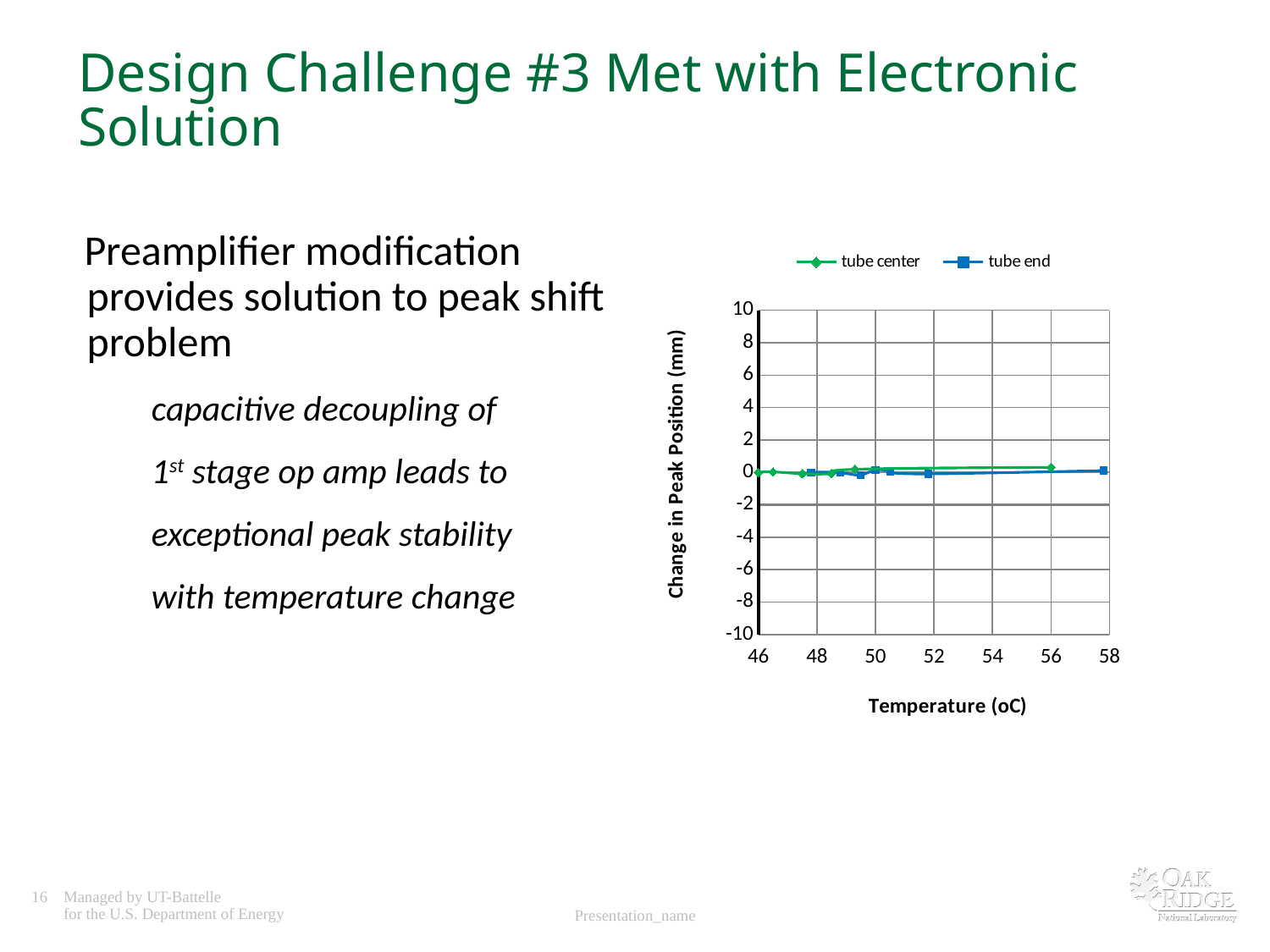
Is the tube end value at a temperature of 58 greater or less than 2? less What are the two series named in the chart legend? tube center and tube end Is the tube center value at a temperature of 56 greater or less than -2? greater Is the tube center value at a temperature of 56 greater or less than 2? less What is the title of the chart's vertical axis? Change in Peak Position (mm) Do the tube end values rise, fall, or stay roughly flat as temperature increases along the x axis? stay roughly flat Do the tube center values rise, fall, or stay roughly flat as temperature increases from 46 to 58? stay roughly flat What kind of chart is shown on the slide? line chart How many series does the chart legend list? 2